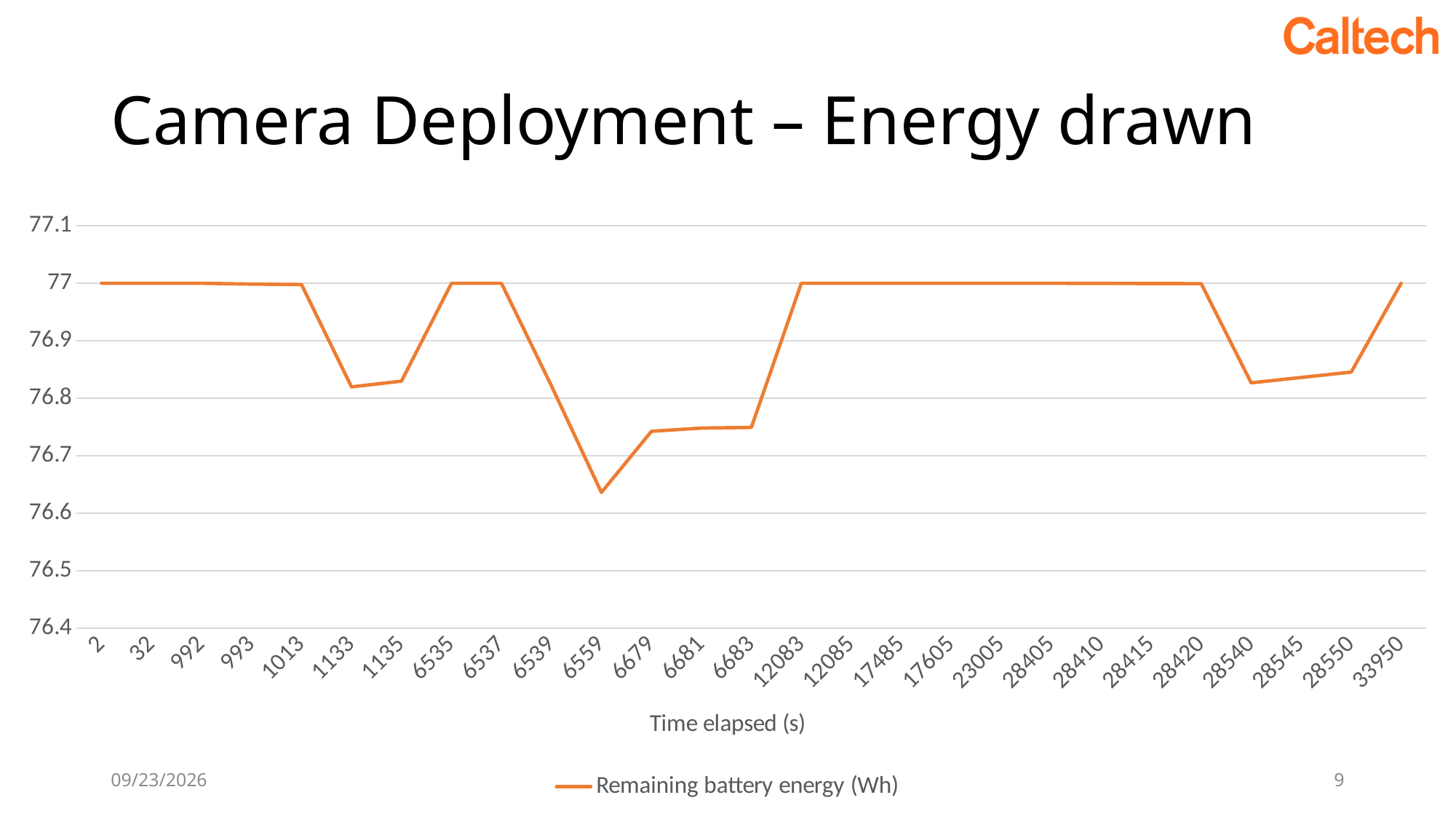
Is the remaining battery energy at 6559 s greater or less than 76.7? less How many series does the legend list? 1 What kind of chart is shown on the slide? line chart How many time points are plotted along the x axis? 27 Does the remaining battery energy rise or fall between 6537 s and 6559 s? fall What is the title of the x axis? Time elapsed (s) At which time elapsed is the remaining battery energy lowest? 6559 What is the name of the series shown in the legend? Remaining battery energy (Wh) Is the remaining battery energy at 6683 s greater or less than 76.8? less Which has the higher remaining battery energy, 6683 s or 28540 s? 28540 Which has the higher remaining battery energy, 1133 s or 6559 s? 1133 Is the remaining battery energy at 1133 s greater or less than 76.8? greater